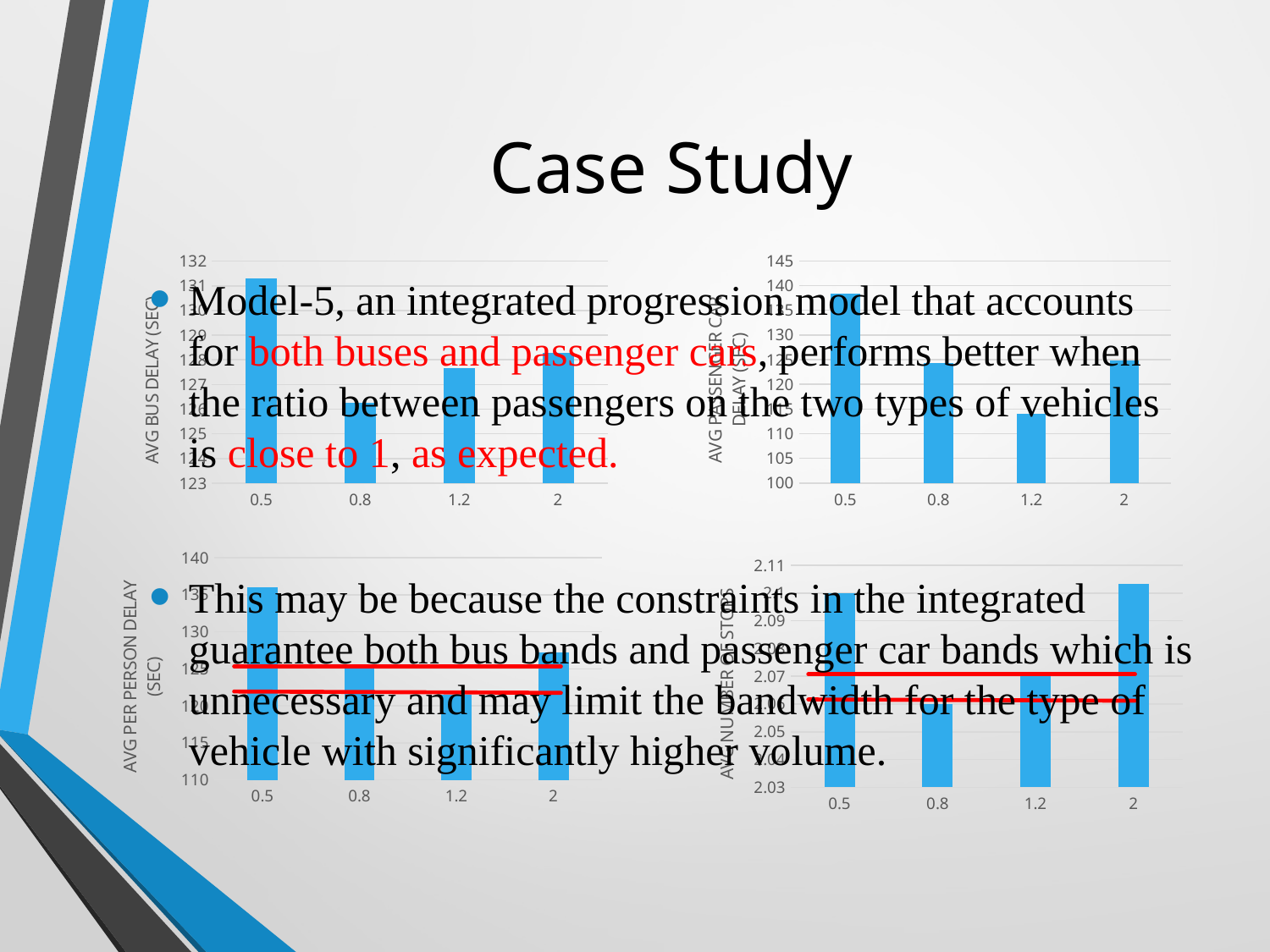
What kind of chart is the top-left chart (AVG BUS DELAY)? bar chart In the top-left chart (AVG BUS DELAY), which category has the lowest value? 0.8 In the top-left chart (AVG BUS DELAY), which category has the highest value? 0.5 How many charts are shown on the slide? 4 In the top-left chart (AVG BUS DELAY), how many categories are on the x axis? 4 In the top-right chart (AVG PASSENGER CAR DELAY), which category has the lowest value? 1.2 In the top-right chart (AVG PASSENGER CAR DELAY), is the value for 0.5 greater or less than 135? greater In the bottom-right chart (AVG NUMBER OF STOPS), which is larger, the value for 0.5 or the value for 0.8? 0.5 In the bottom-right chart (AVG NUMBER OF STOPS), which category has the highest value? 2 In the top-right chart (AVG PASSENGER CAR DELAY), is the value for 1.2 greater or less than 120? less In the bottom-left chart (AVG PER PERSON DELAY), which category has the highest value? 0.5